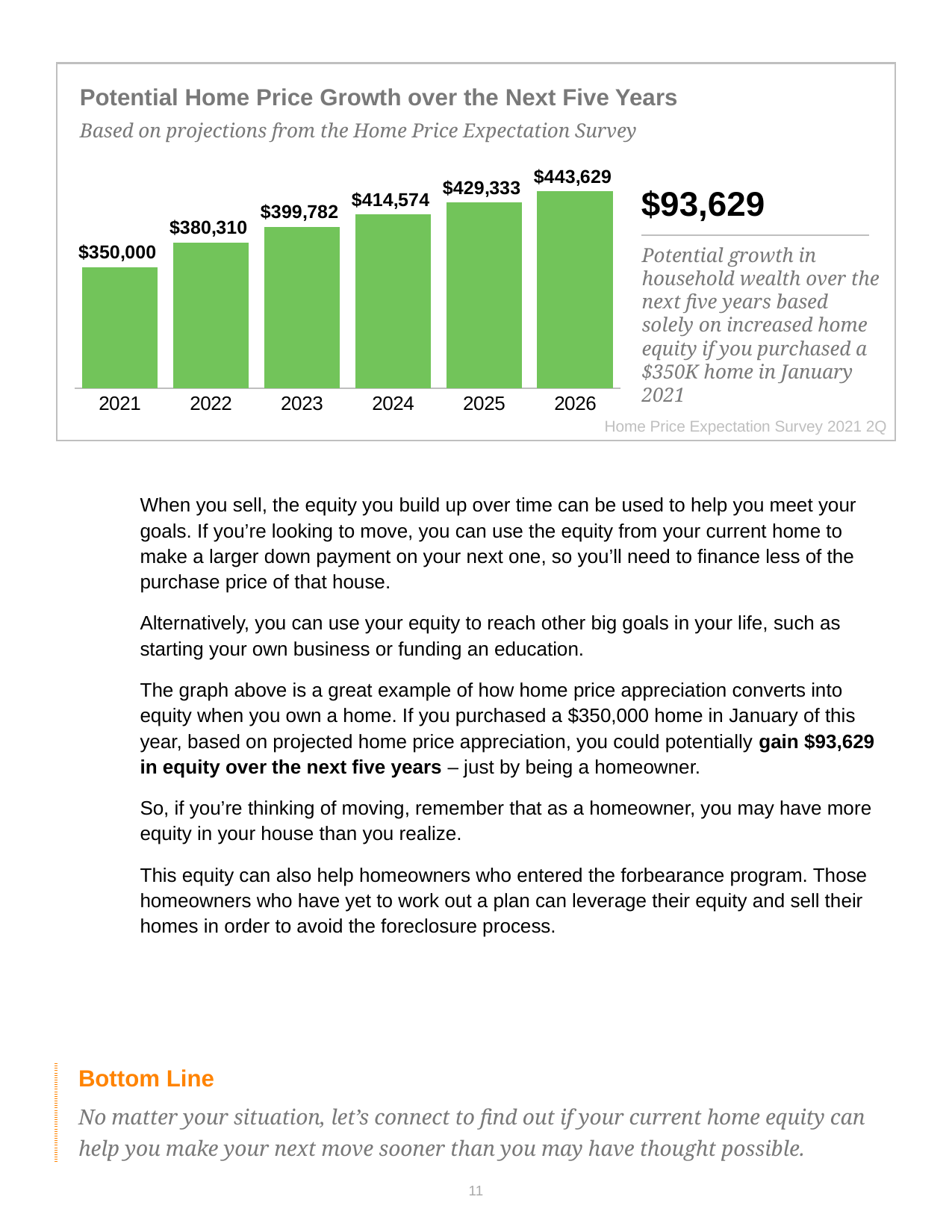
What kind of chart is shown on the slide? Bar chart What is the title of the chart? Potential Home Price Growth over the Next Five Years Which year has the lowest home price on the chart? 2021 What is the projected home price for 2026? $443,629 Which is larger, the projected home price for 2022 or for 2024? 2024 What is the projected home price for 2023? $399,782 Do the projected home prices rise or fall from 2021 to 2026? Rise How many years are shown on the chart? 6 Which year has the highest projected home price? 2026 What is the difference between the projected home prices for 2025 and 2024? $14,759 What is the home price shown for 2021? $350,000 What is the difference between the projected home price in 2026 and the price in 2021? $93,629